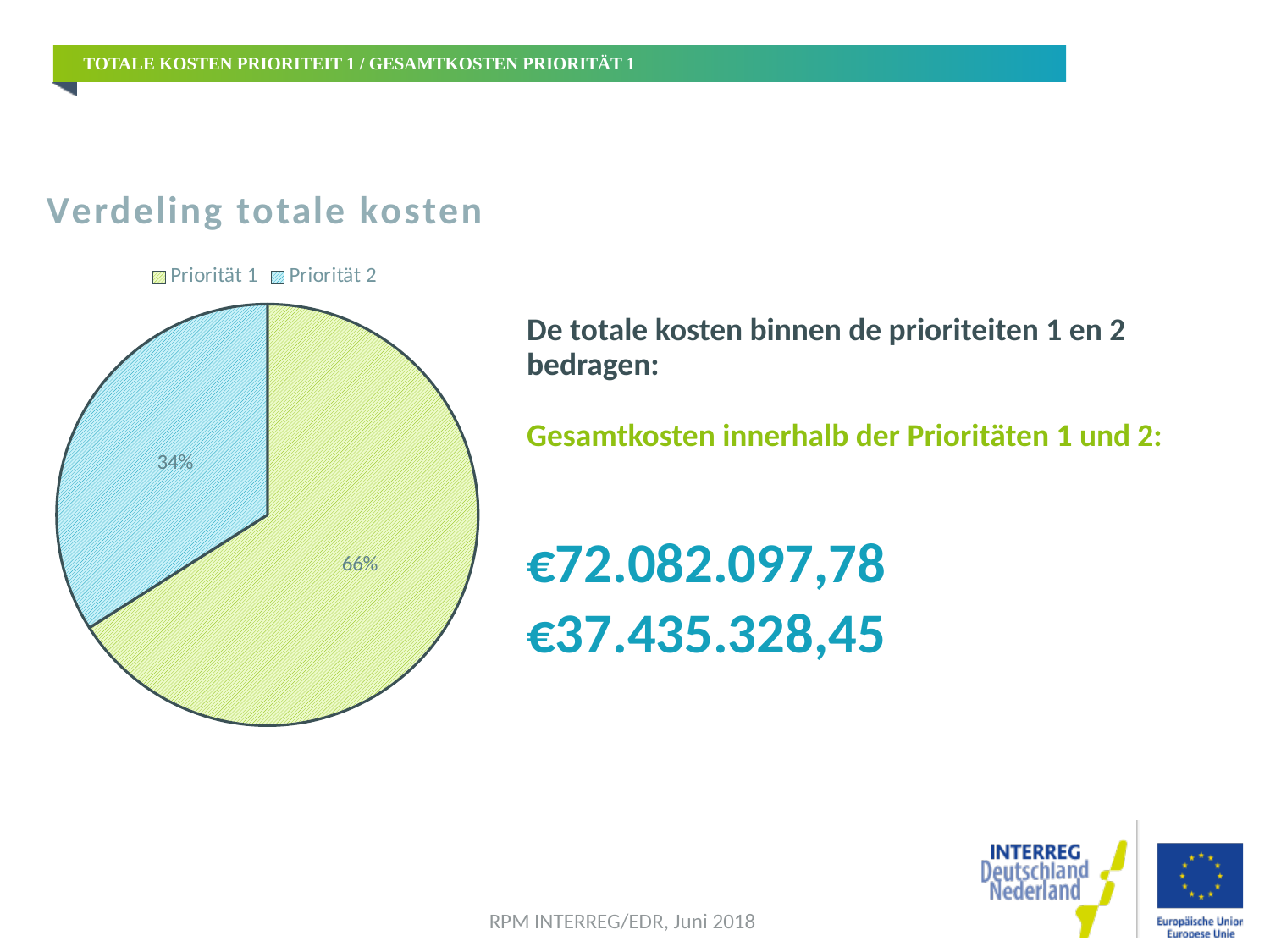
How many slices does the pie chart have? 2 Which legend entry is shown in blue? Priorität 2 How many entries does the chart legend list? 2 What share of the pie does Priorität 2 represent? 34% What is the title of the chart? Verdeling totale kosten Which slice of the pie is the largest? Priorität 1 What kind of chart is shown on the slide? pie chart What is the difference in percentage points between the Priorität 1 and Priorität 2 shares? 32 Which slice of the pie is the smallest? Priorität 2 What share of the pie does Priorität 1 represent? 66% Is the share for Priorität 1 greater or less than 50%? greater Which is larger, the share for Priorität 1 or the share for Priorität 2? Priorität 1